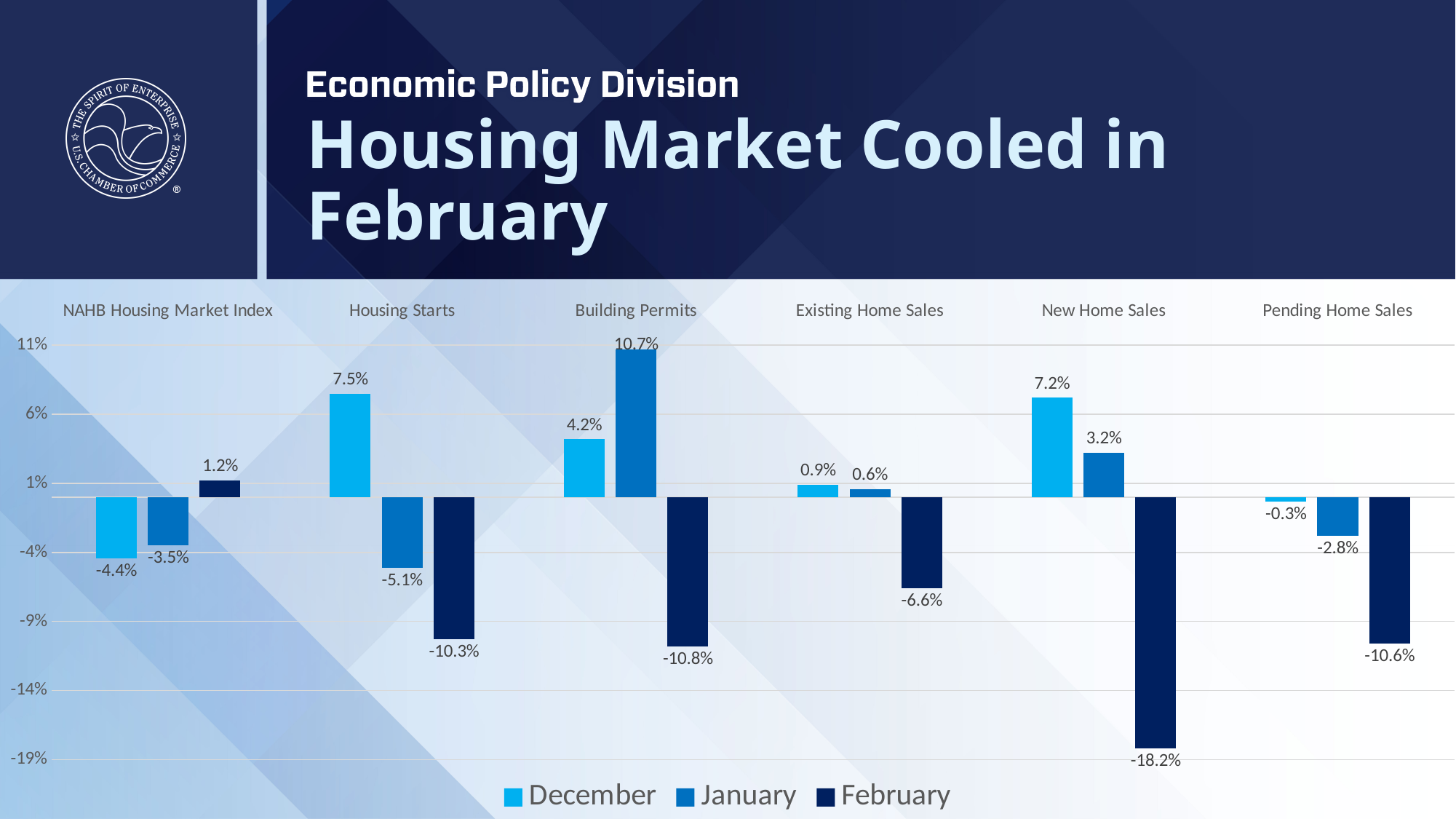
What is the December value for Housing Starts? 7.5% What is the difference between the December and January values for New Home Sales? 4.0 percentage points How many series does the legend list? 3 How many categories are shown on the chart? 6 What is the February value for New Home Sales? -18.2% What is the February value for the NAHB Housing Market Index? 1.2% Which category has the highest January value? Building Permits What is the January value for Building Permits? 10.7% Which category has the lowest February value? New Home Sales Which series is shown in the darkest blue colour? February What kind of chart is shown on the slide? Bar chart Which is larger, the February value for Housing Starts or the February value for Building Permits? Housing Starts